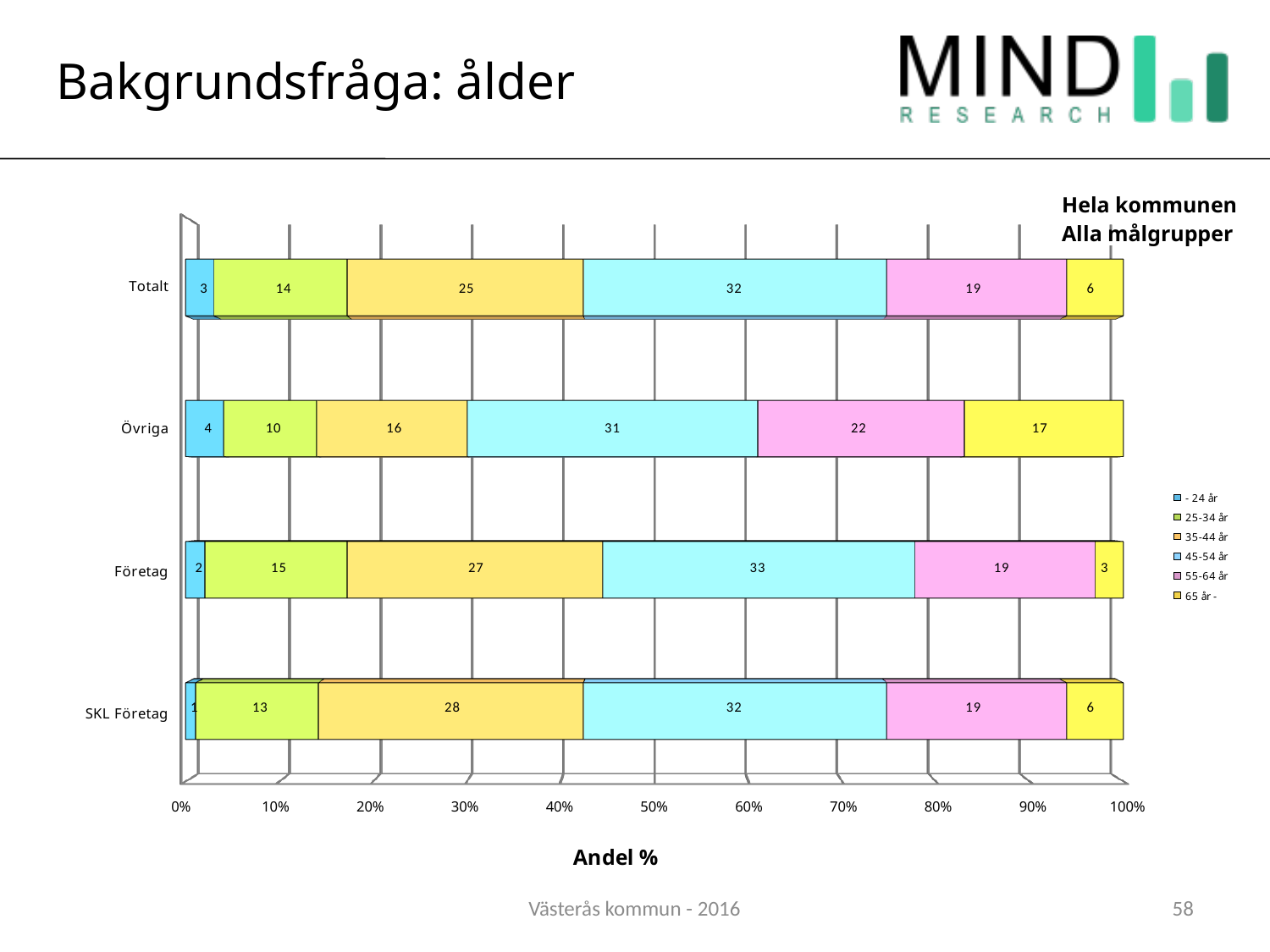
How many series does the legend list? 6 What is the value for the 65 år - series in the Övriga bar? 17 How many categories are shown on the y axis? 4 What is the value for the 45-54 år series in the Totalt bar? 32 Which category has the highest value for the 65 år - series? Övriga What is the value for the 35-44 år series in the Företag bar? 27 What is the difference between the 35-44 år values for SKL Företag and Övriga? 12 Which category has the lowest value for the - 24 år series? SKL Företag Which is larger: the 55-64 år value for Övriga or for Företag? Övriga What kind of chart is shown on the slide? Stacked bar chart What is the label of the x axis? Andel % What is the value for the 25-34 år series in the SKL Företag bar? 13